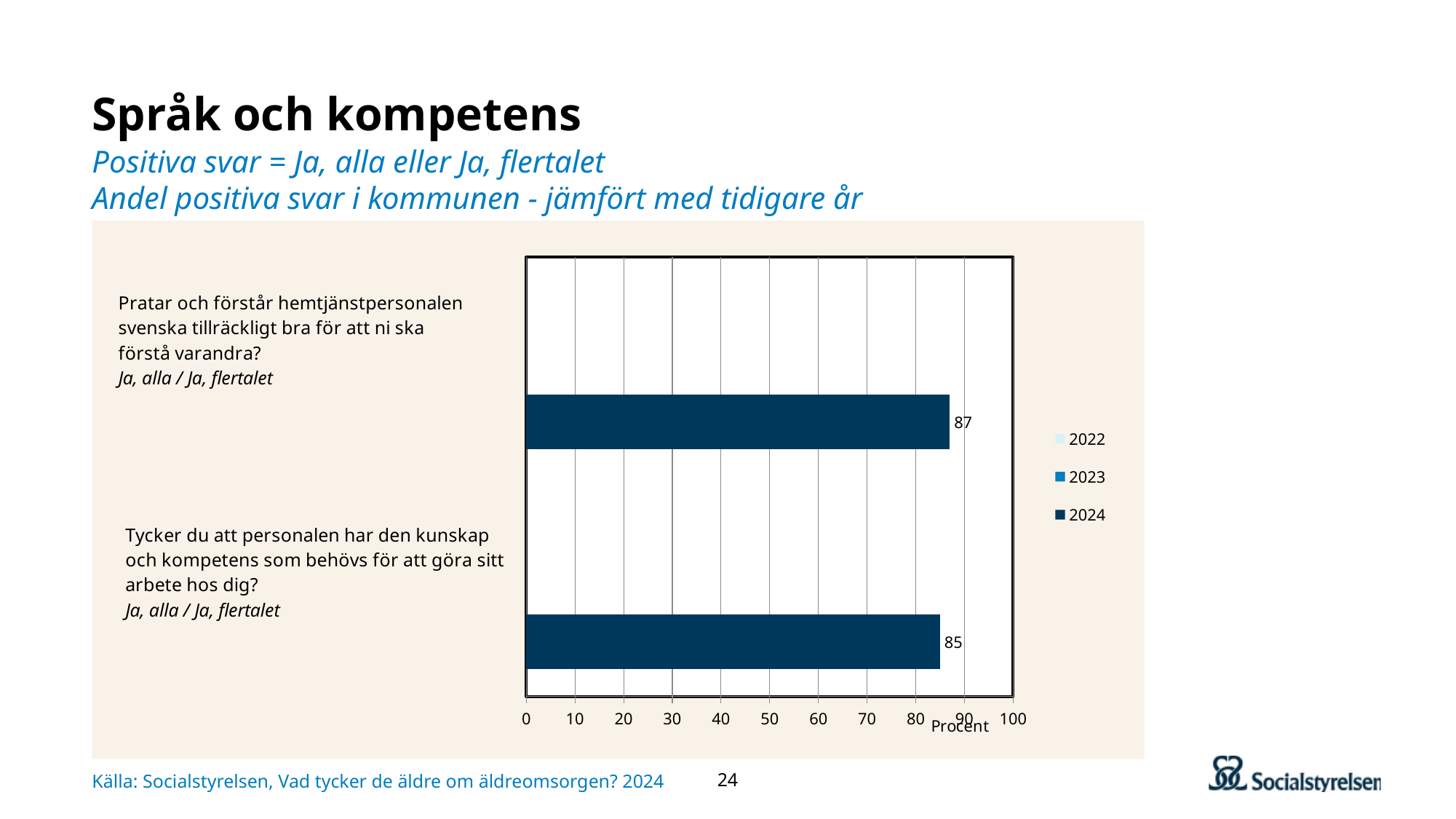
How many questions (categories) are shown in the chart? 2 How many series does the legend list? 3 What is the 2024 value for "Tycker du att personalen har den kunskap och kompetens som behövs för att göra sitt arbete hos dig?" 85 Which years are listed in the chart legend? 2022, 2023, 2024 Is the 2024 value for the question about staff knowledge and competence greater or less than 80? greater What kind of chart is shown on the slide? Bar chart What is the difference between the two 2024 values shown in the chart? 2 Which question has the higher 2024 value? Pratar och förstår hemtjänstpersonalen svenska tillräckligt bra för att ni ska förstå varandra? Is the 2024 value for the question about staff speaking Swedish greater or less than 90? less Which question has the lower 2024 value? Tycker du att personalen har den kunskap och kompetens som behövs för att göra sitt arbete hos dig? What is the 2024 value for "Pratar och förstår hemtjänstpersonalen svenska tillräckligt bra för att ni ska förstå varandra?" 87 What label is shown on the horizontal axis of the chart? Procent